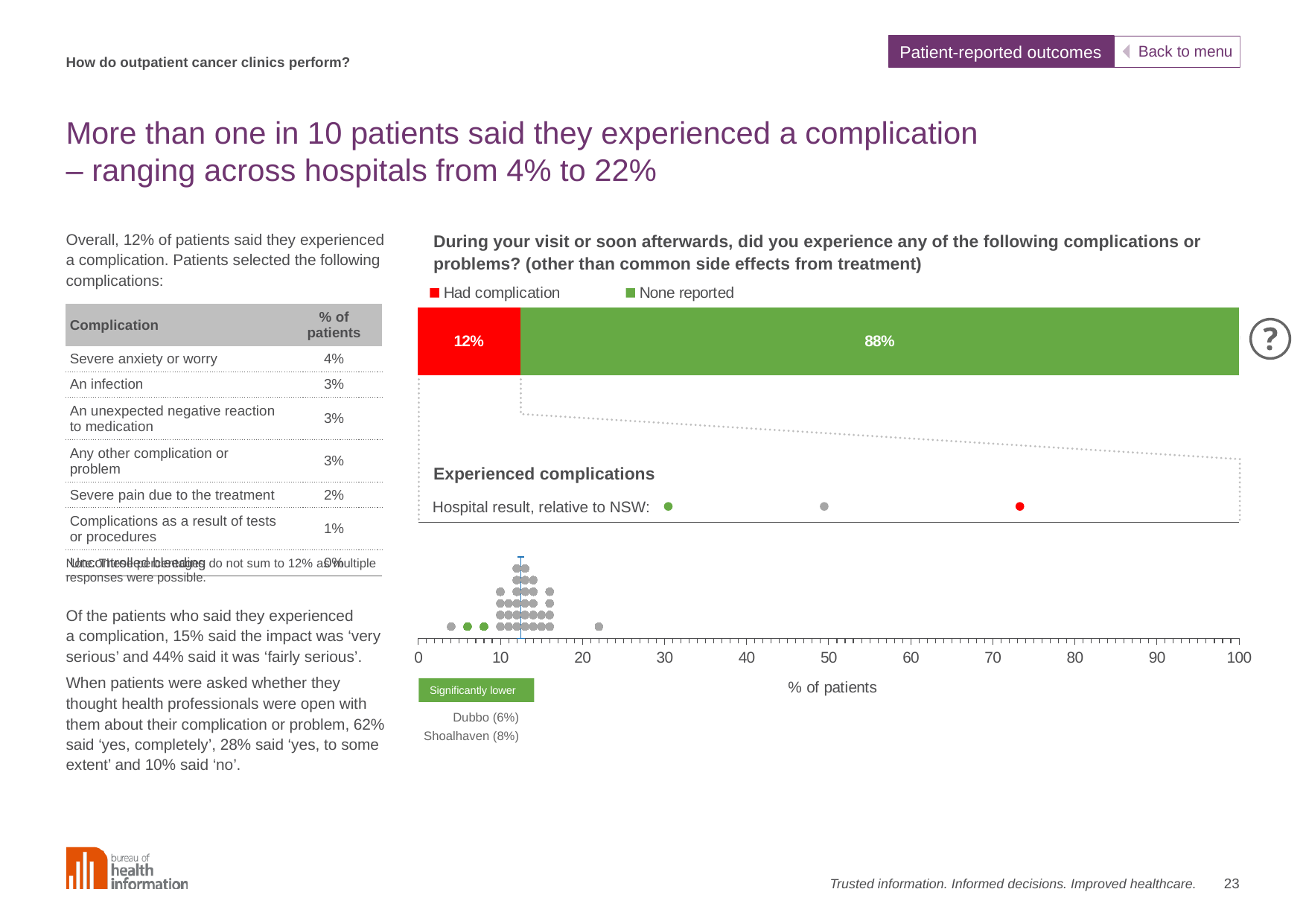
What is the x-axis label of the 'Experienced complications' dot plot? % of patients In the stacked bar chart, what colour represents 'Had complication'? Red In the stacked bar chart, is the value for 'Had complication' greater or less than 50? less In the stacked bar chart, what is the difference between 'None reported' and 'Had complication'? 76 percentage points In the 'Experienced complications' dot plot, what is the value for Shoalhaven, listed as significantly lower? 8% How many series does the legend of the stacked bar chart list? 2 In the stacked bar chart, what percentage of patients had a complication? 12% In the 'Experienced complications' dot plot, what is the value for Dubbo, listed as significantly lower? 6% In the stacked bar chart, which is larger: 'Had complication' or 'None reported'? None reported What is the total of the two segments in the stacked bar chart? 100% In the stacked bar chart, what percentage of patients reported no complication ('None reported')? 88% What kind of chart shows the 'Had complication' and 'None reported' values? Stacked bar chart